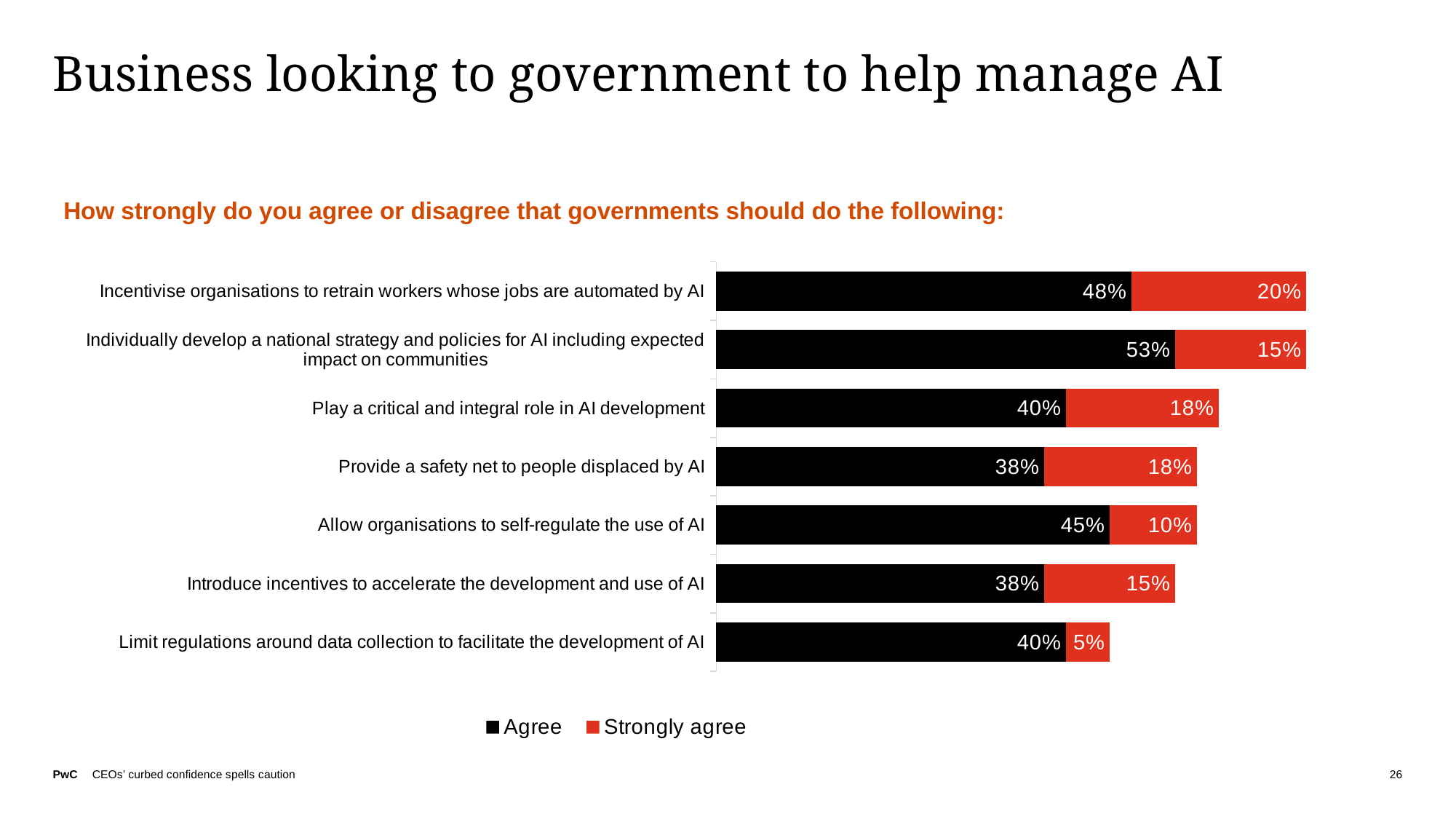
Which category has the highest 'Agree' value? Individually develop a national strategy and policies for AI including expected impact on communities Which has a larger 'Agree' value: 'Allow organisations to self-regulate the use of AI' or 'Provide a safety net to people displaced by AI'? Allow organisations to self-regulate the use of AI What is the combined total of 'Agree' and 'Strongly agree' for 'Play a critical and integral role in AI development'? 58% Which category has the lowest 'Strongly agree' value? Limit regulations around data collection to facilitate the development of AI What is the 'Strongly agree' value for 'Limit regulations around data collection to facilitate the development of AI'? 5% What is the combined total of 'Agree' and 'Strongly agree' for 'Incentivise organisations to retrain workers whose jobs are automated by AI'? 68% What percentage of respondents 'Agree' that governments should incentivise organisations to retrain workers whose jobs are automated by AI? 48% What kind of chart is shown on the slide? Stacked bar chart How many categories are shown in the chart? 7 How many series does the legend list? 2 What is the difference between the 'Strongly agree' values for 'Incentivise organisations to retrain workers whose jobs are automated by AI' and 'Allow organisations to self-regulate the use of AI'? 10% Which colour represents the 'Strongly agree' series in the chart? Red